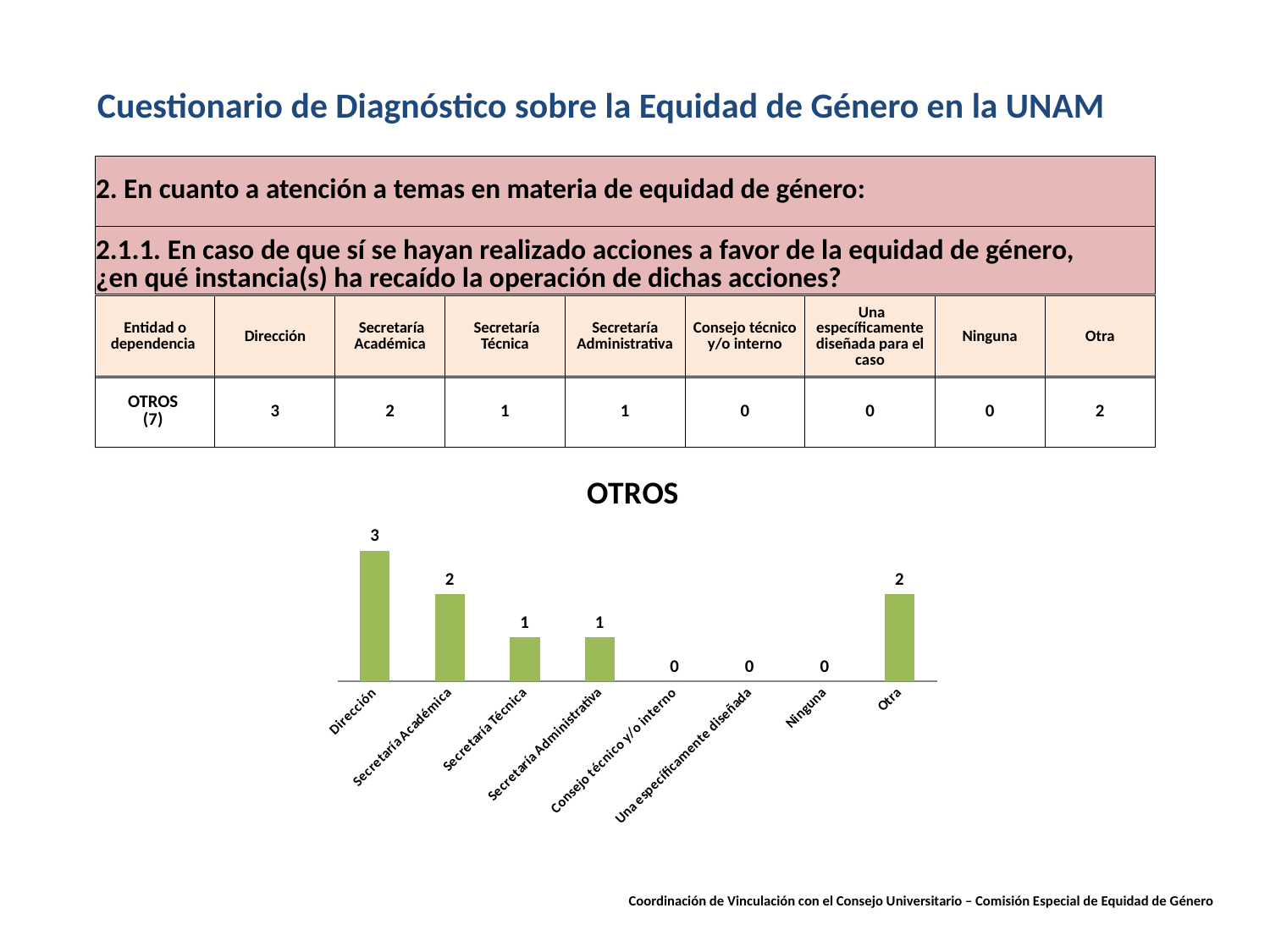
How many categories are shown on the x axis of the OTROS chart? 8 What is the value for Dirección in the OTROS chart? 3 What is the value for Ninguna in the OTROS chart? 0 What kind of chart is the OTROS chart? Bar chart What is the value for Secretaría Académica in the OTROS chart? 2 Which category has the highest value in the OTROS chart? Dirección What is the value for Secretaría Técnica in the OTROS chart? 1 How many categories in the OTROS chart have a value of 0? 3 Which is larger in the OTROS chart, the value for Secretaría Académica or the value for Secretaría Administrativa? Secretaría Académica What is the value for Otra in the OTROS chart? 2 What is the difference between the values for Dirección and Secretaría Técnica in the OTROS chart? 2 What is the title of the chart on the slide? OTROS